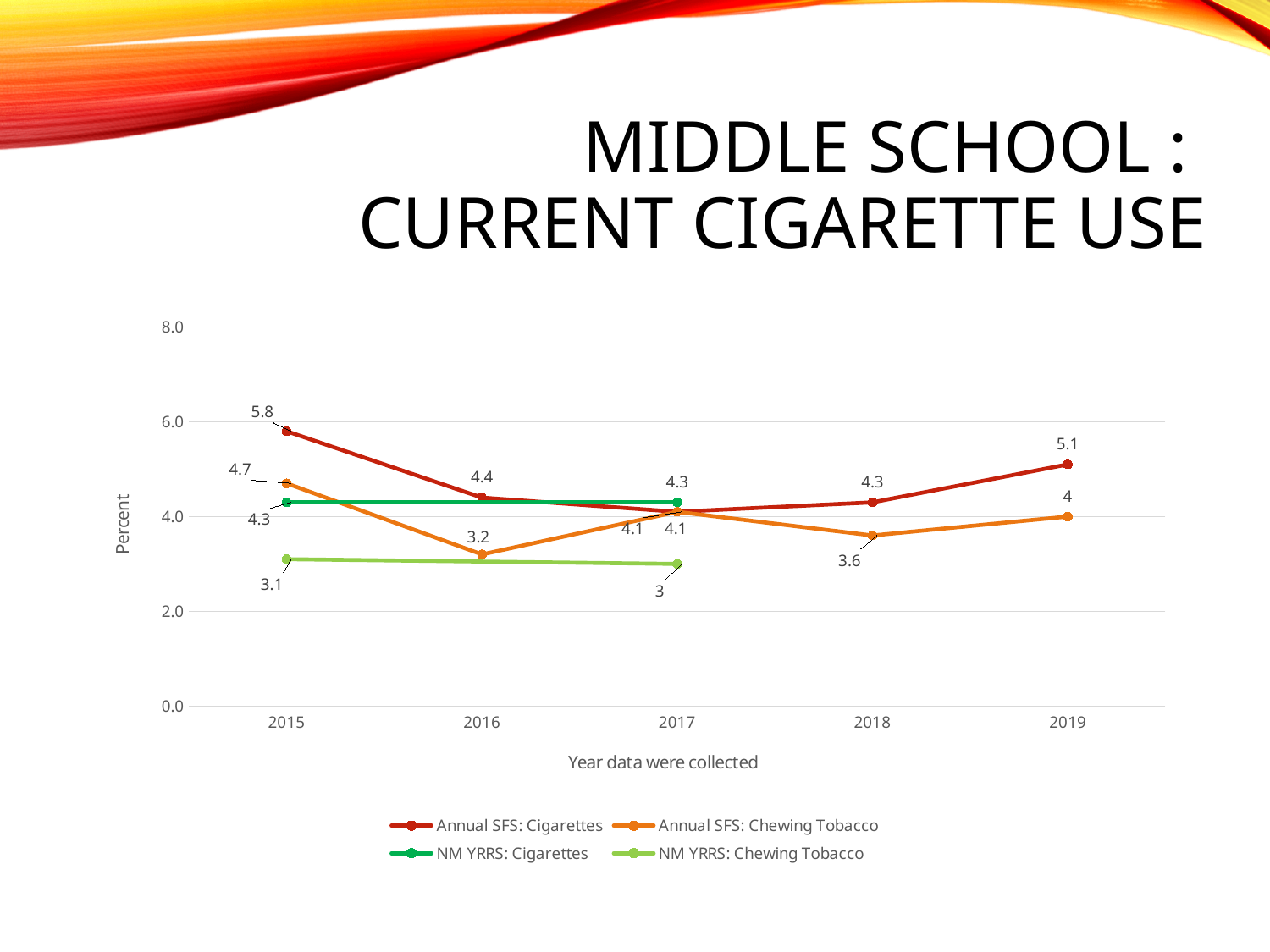
In 2018, which is larger: Annual SFS: Cigarettes or Annual SFS: Chewing Tobacco? Annual SFS: Cigarettes In which year is the Annual SFS: Chewing Tobacco value lowest? 2016 What kind of chart is shown on the slide? Line chart How many years are shown on the x axis? 5 In which year is the Annual SFS: Cigarettes value highest? 2015 Does the Annual SFS: Cigarettes value rise or fall from 2015 to 2017? Fall How many series does the legend list? 4 What is the value for Annual SFS: Chewing Tobacco in 2016? 3.2 What is the difference between the Annual SFS: Cigarettes values in 2015 and 2019? 0.7 What is the value for NM YRRS: Chewing Tobacco in 2017? 3 What is the value for NM YRRS: Cigarettes in 2015? 4.3 What is the value for Annual SFS: Cigarettes in 2015? 5.8